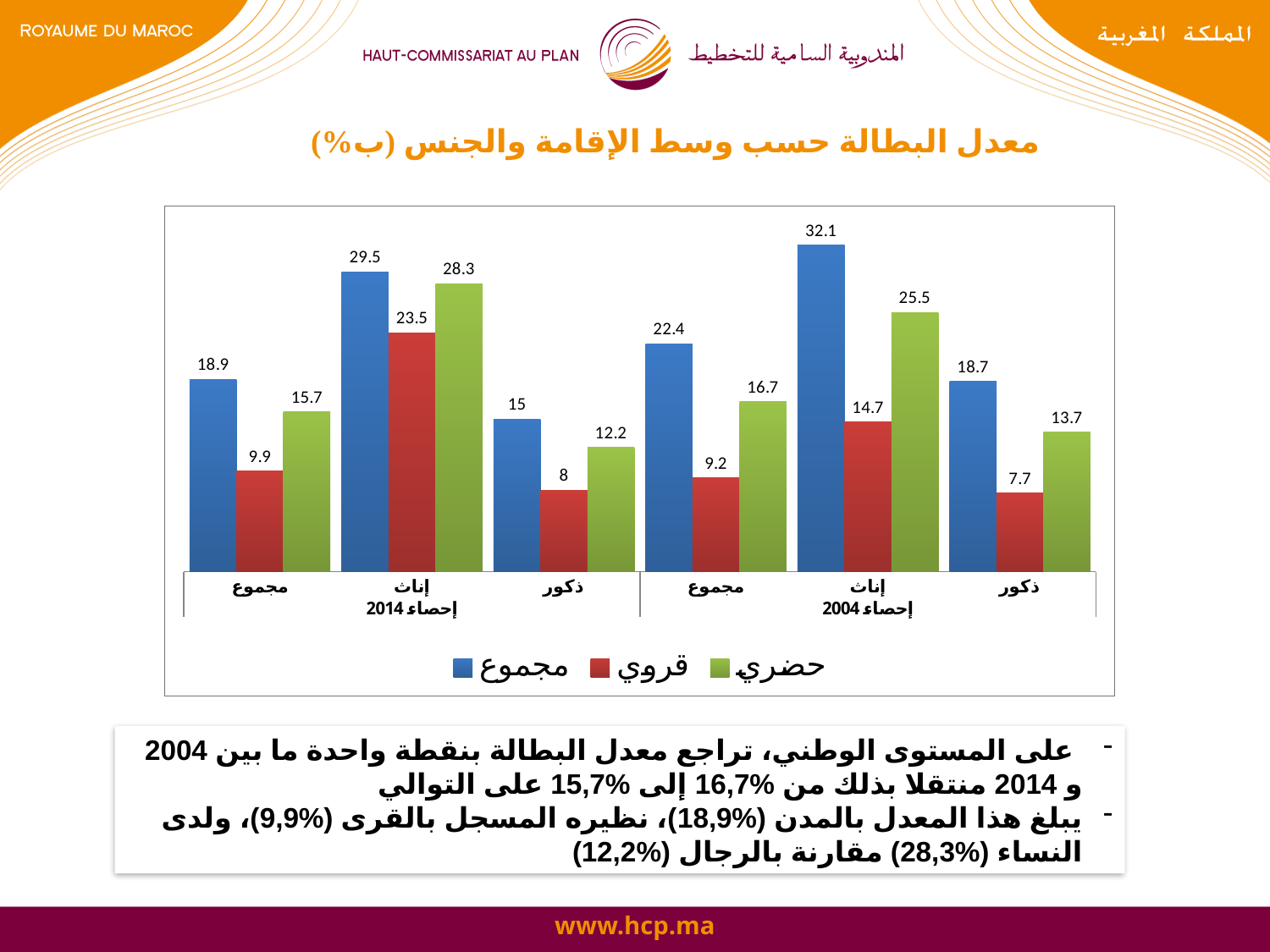
What type of chart is shown on the slide? Bar chart What is the difference between the urban and rural unemployment rates for males (ذكور) in the 2014 census? 4.2 How many category groups are shown along the x axis? 6 Which bar shows the highest unemployment rate on the chart? Total (مجموع) females (إناث), 2004 census: 32.1 How many series does the legend list? 3 What is the title of the chart? معدل البطالة حسب وسط الإقامة والجنس (ب%) Which bar shows the lowest unemployment rate on the chart? Rural (قروي) males (ذكور), 2004 census: 7.7 What is the rural (قروي) unemployment rate for the total (مجموع) group in the 2004 census? 9.2 What is the urban (حضري) unemployment rate for females (إناث) in the 2014 census? 28.3 Is the rural (قروي) unemployment rate for females (إناث) higher in the 2014 census or the 2004 census? 2014 census